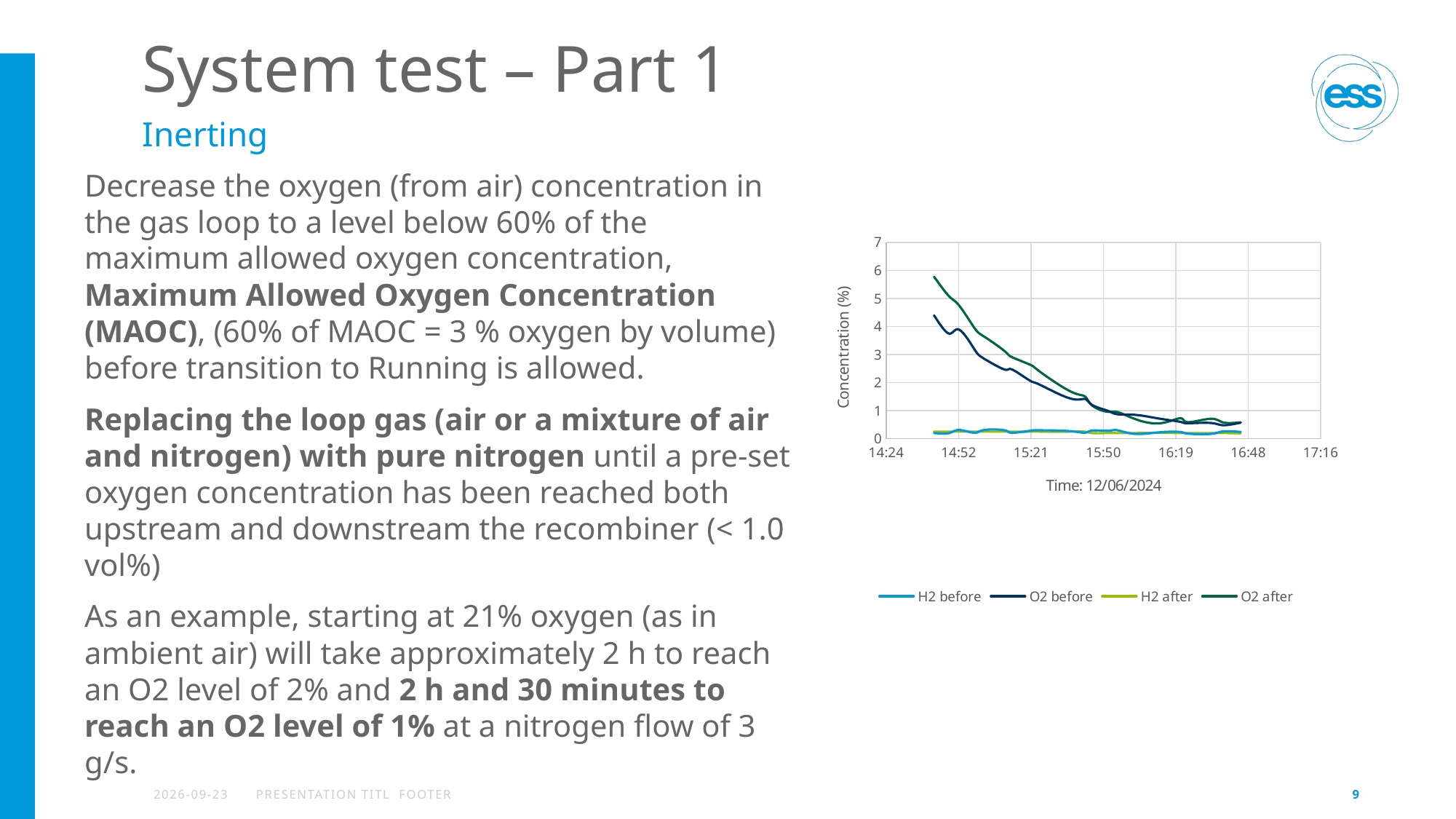
What kind of chart is shown on the slide? line chart Which series is higher at 15:21: O2 before or H2 before? O2 before At the start of the measurement, is the O2 after concentration greater or less than 5? greater Which series reaches the highest concentration value on the chart? O2 after At the start of the measurement, which is higher: O2 before or O2 after? O2 after How many series does the chart legend list? 4 At the start of the measurement, is the O2 before concentration greater or less than 4? greater Do the O2 before and O2 after lines rise or fall over time along the x axis? fall What is the label of the horizontal axis of the chart? Time: 12/06/2024 Around 16:48, is the O2 before concentration greater or less than 1? less What is the label of the vertical axis of the chart? Concentration (%)